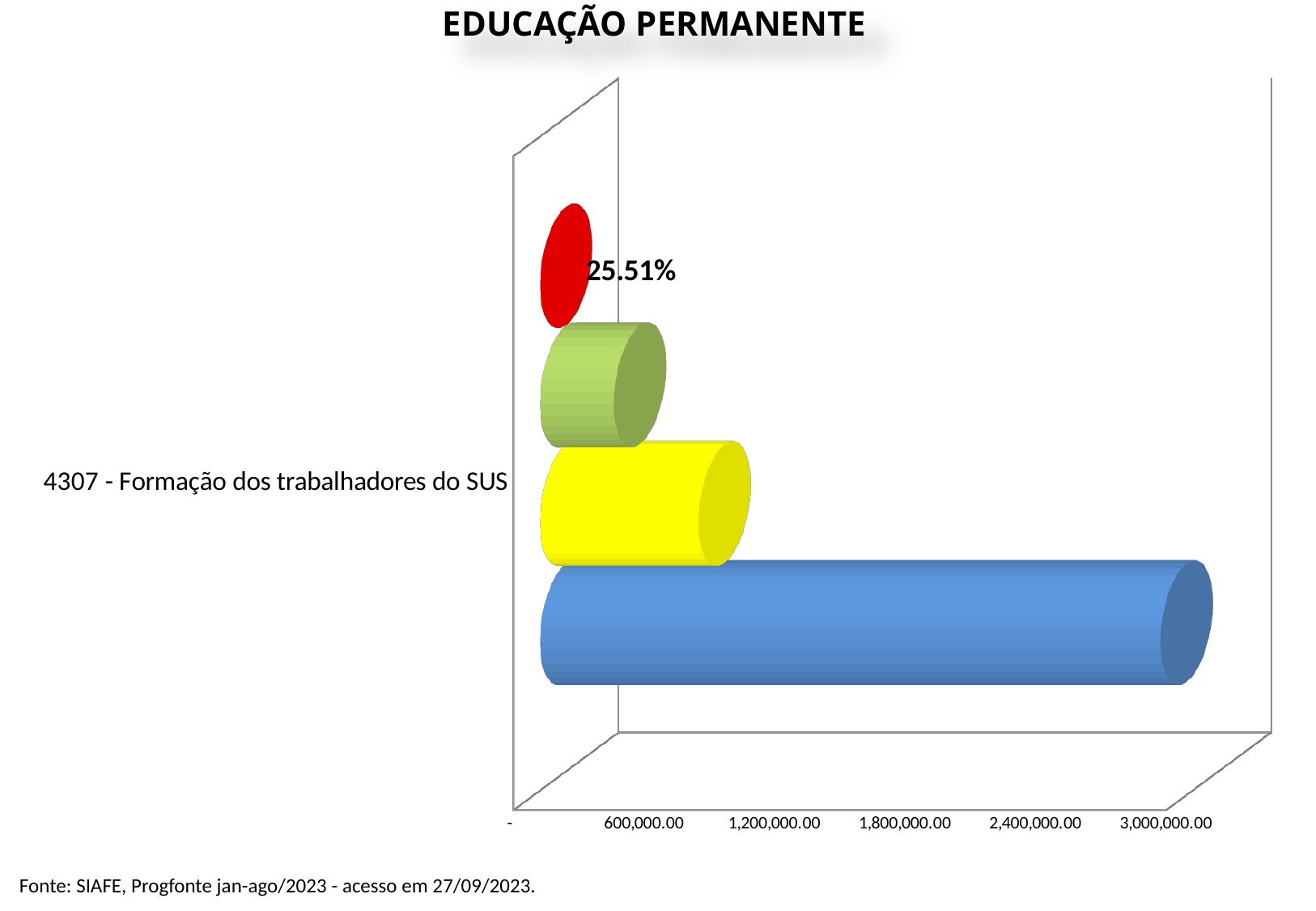
What percentage value is printed as a data label on the chart? 25.51% What kind of chart is shown on the slide? bar chart Is the value of the blue bar greater or less than 2,400,000.00? greater Which colour bar carries the 25.51% data label? red What is the category label shown on the chart? 4307 - Formação dos trabalhadores do SUS Which colour bar is the longest in the chart? blue How many categories are shown on the vertical axis of the chart? 1 Is the value of the yellow bar greater or less than 600,000.00? greater Which colour bar is the shortest in the chart? red What is the title of the chart? EDUCAÇÃO PERMANENTE Is the value of the red bar greater or less than 600,000.00? less Which is larger, the blue bar or the yellow bar? the blue bar